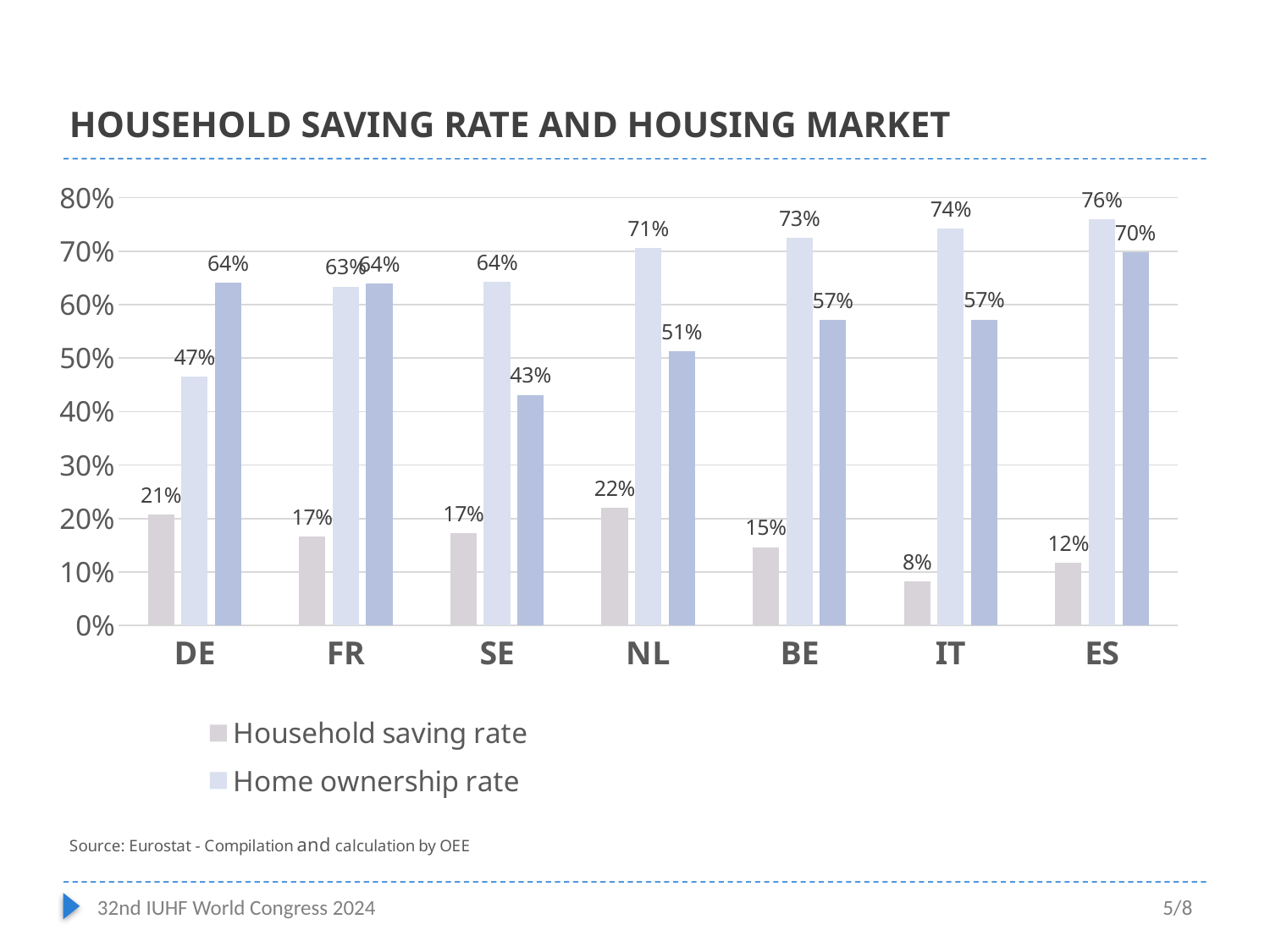
Which country has the lowest home ownership rate? DE Which country has the highest home ownership rate? ES Is the home ownership rate for BE greater or less than 70%? greater What is the difference between the home ownership rate of ES and that of DE? 29% Which is larger, the household saving rate of NL or of BE? NL What is the household saving rate for DE? 21% How many countries are shown on the x axis? 7 How many series does the legend list? 2 What kind of chart is shown on the slide? bar chart What is the home ownership rate for NL? 71% What is the household saving rate for IT? 8% Which country has the lowest household saving rate? IT